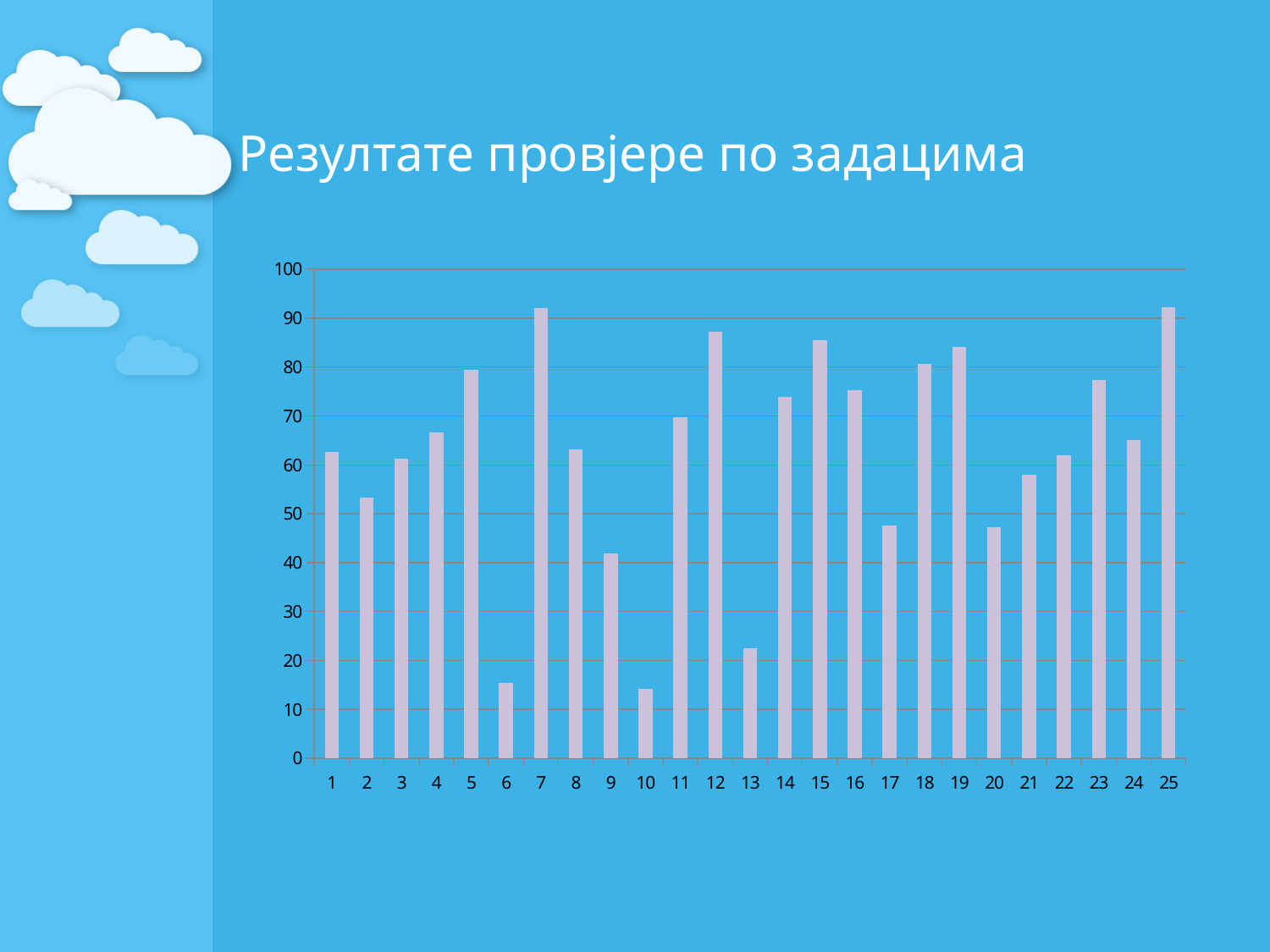
Which has the larger value, category 5 or category 6? category 5 What is the title of the chart slide? Резултате провјере по задацима Is the value for category 7 greater or less than 90? greater What kind of chart is shown on the slide? bar chart Which has the larger value, category 12 or category 13? category 12 Which has the larger value, category 17 or category 18? category 18 Is the value for category 6 greater or less than 20? less Is the value for category 12 greater or less than 80? greater How many categories are shown on the x axis of the chart? 25